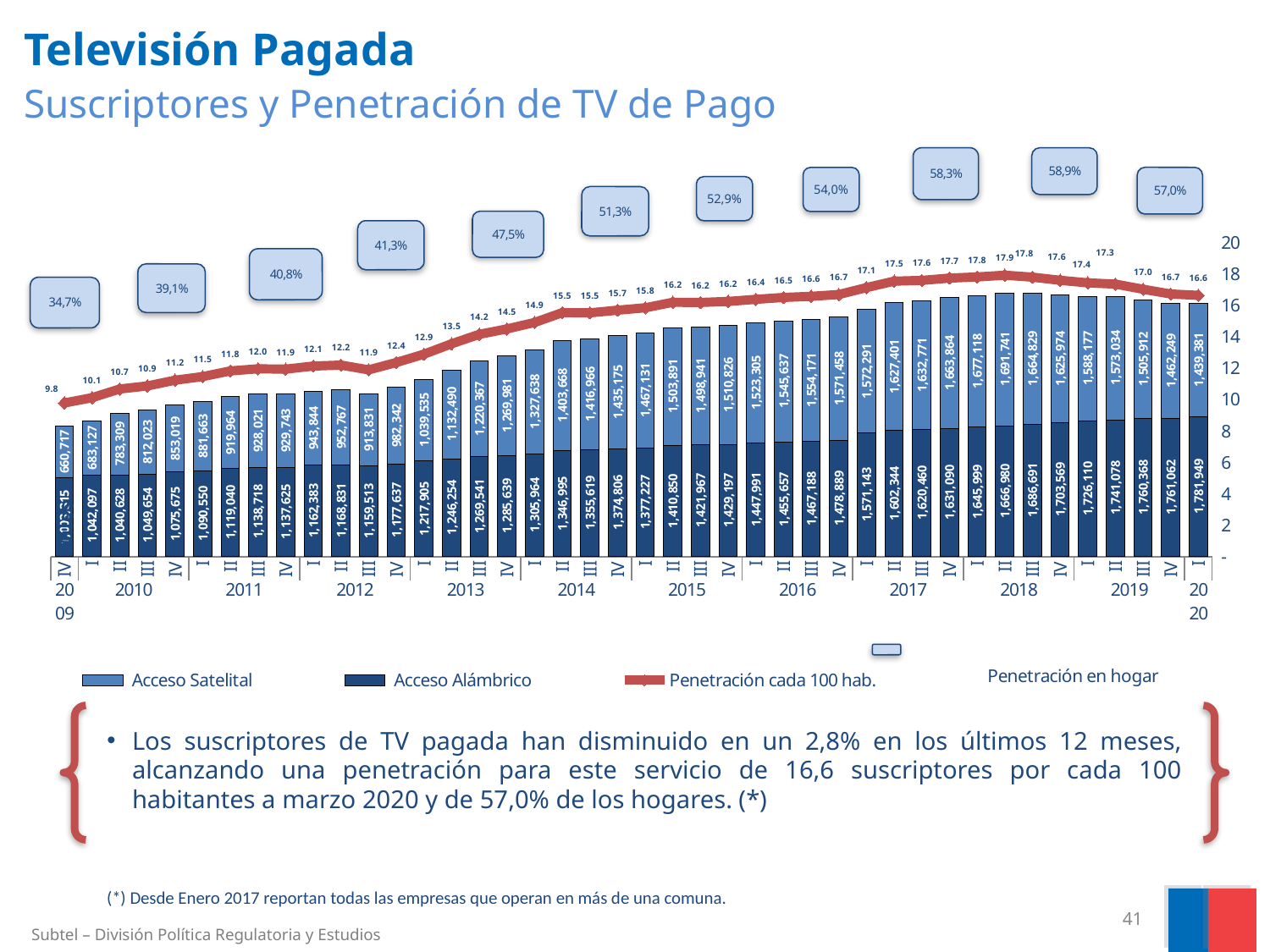
What is the Penetración en hogar value shown above 2018? 58,9% What is the highest value of Acceso Satelital in the chart? 1,691,741 What is the Penetración cada 100 hab. value for I 2020? 16.6 What is the highest value of the Penetración cada 100 hab. line? 17.9 Does the Penetración cada 100 hab. line rise or fall from IV 2009 to I 2018? Rises What is the value of Acceso Alámbrico for I 2020? 1,781,949 In I 2020, how much larger is Acceso Alámbrico than Acceso Satelital? 342,568 What is the total of the stacked bar for I 2020 (Acceso Satelital plus Acceso Alámbrico)? 3,221,330 What is the value of Acceso Satelital for I 2020? 1,439,381 In I 2020, which is larger, Acceso Satelital or Acceso Alámbrico? Acceso Alámbrico What kind of chart is shown on the slide? Combination of stacked bar chart and line chart What is the lowest Penetración en hogar value shown in the callout boxes? 34,7%